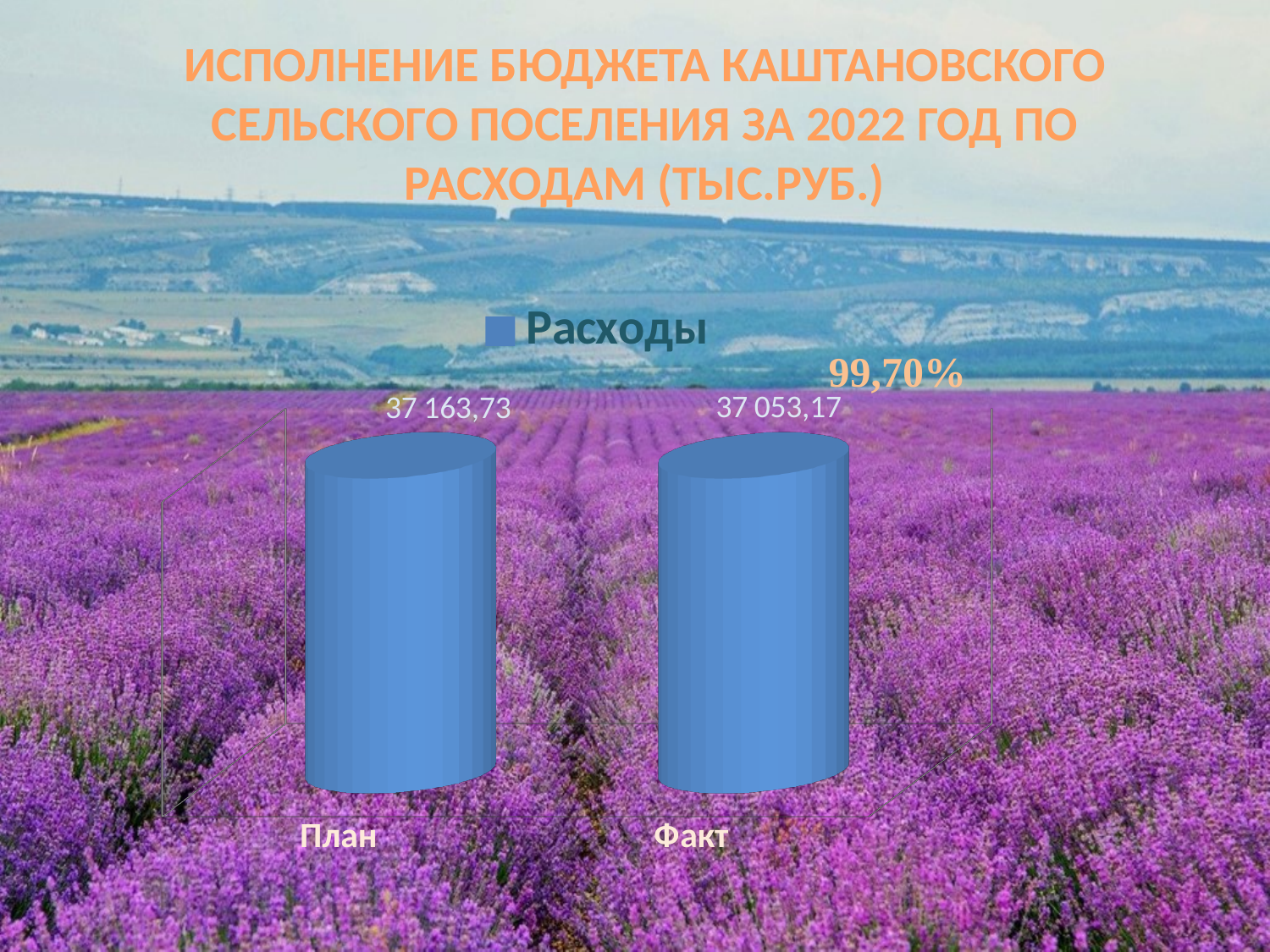
How many series does the chart legend list? 1 What series name is shown in the chart legend? Расходы What kind of chart is shown on the slide? bar chart Which is larger according to the data labels, План or Факт? План What is the value for Факт? 37 053,17 What is the value for План? 37 163,73 What percentage is printed above the Факт bar? 99,70% What is the difference between the values for План and Факт? 110,56 How many categories are shown on the x axis of the chart? 2 Do the values fall or rise from План to Факт? fall